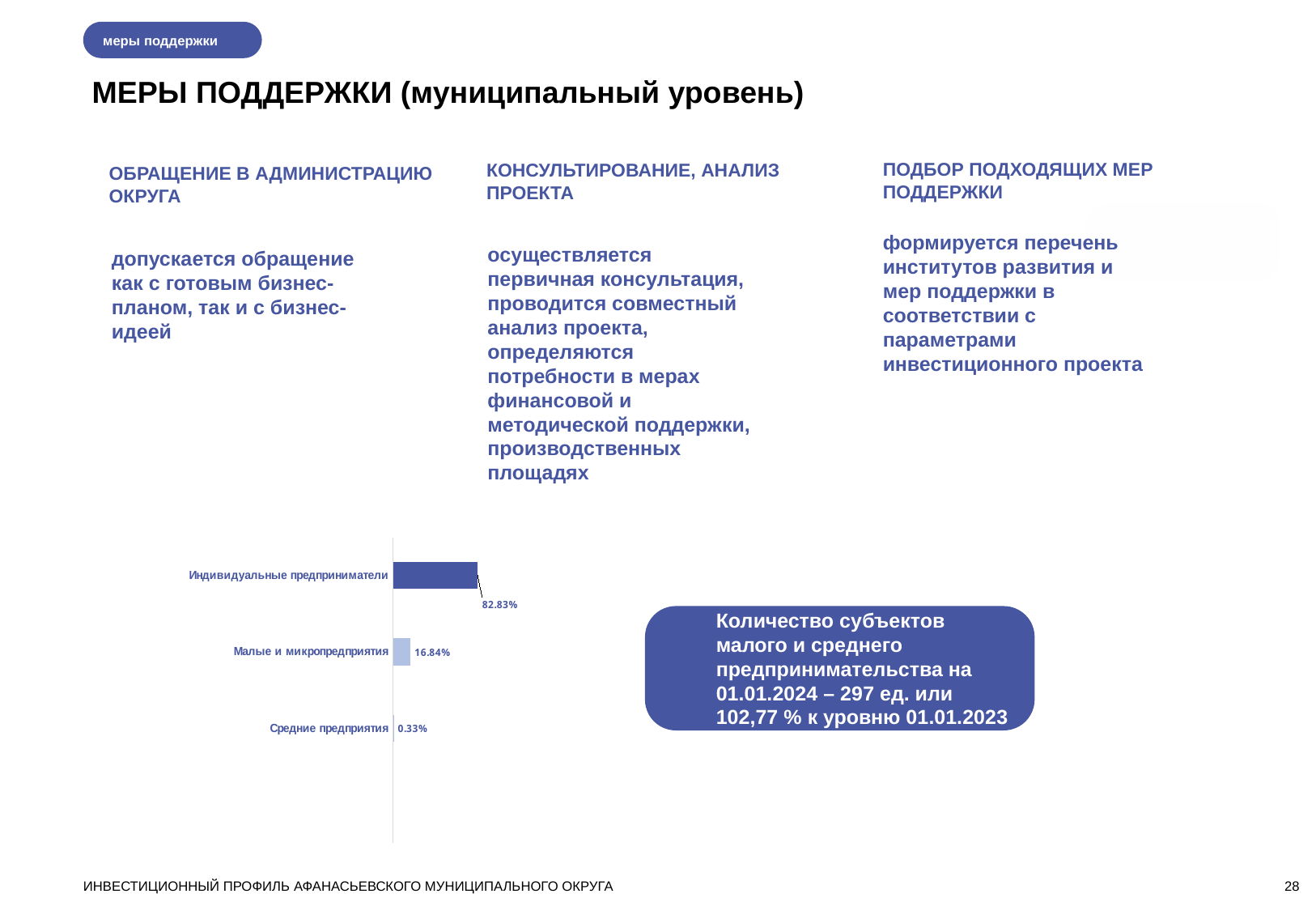
What is the value for Индивидуальные предприниматели? 82.83% Are the bars in the chart oriented horizontally or vertically? horizontally What type of chart is shown on the slide? bar chart How many categories does the bar chart show? 3 What is the difference between the values for Индивидуальные предприниматели and Малые и микропредприятия? 65.99% Which category is listed at the top of the bar chart? Индивидуальные предприниматели Which is larger: the value for Малые и микропредприятия or the value for Средние предприятия? Малые и микропредприятия What is the difference between the values for Малые и микропредприятия and Средние предприятия? 16.51% What is the value for Средние предприятия? 0.33% Which category has the highest value? Индивидуальные предприниматели What is the value for Малые и микропредприятия? 16.84% Which category has the lowest value? Средние предприятия